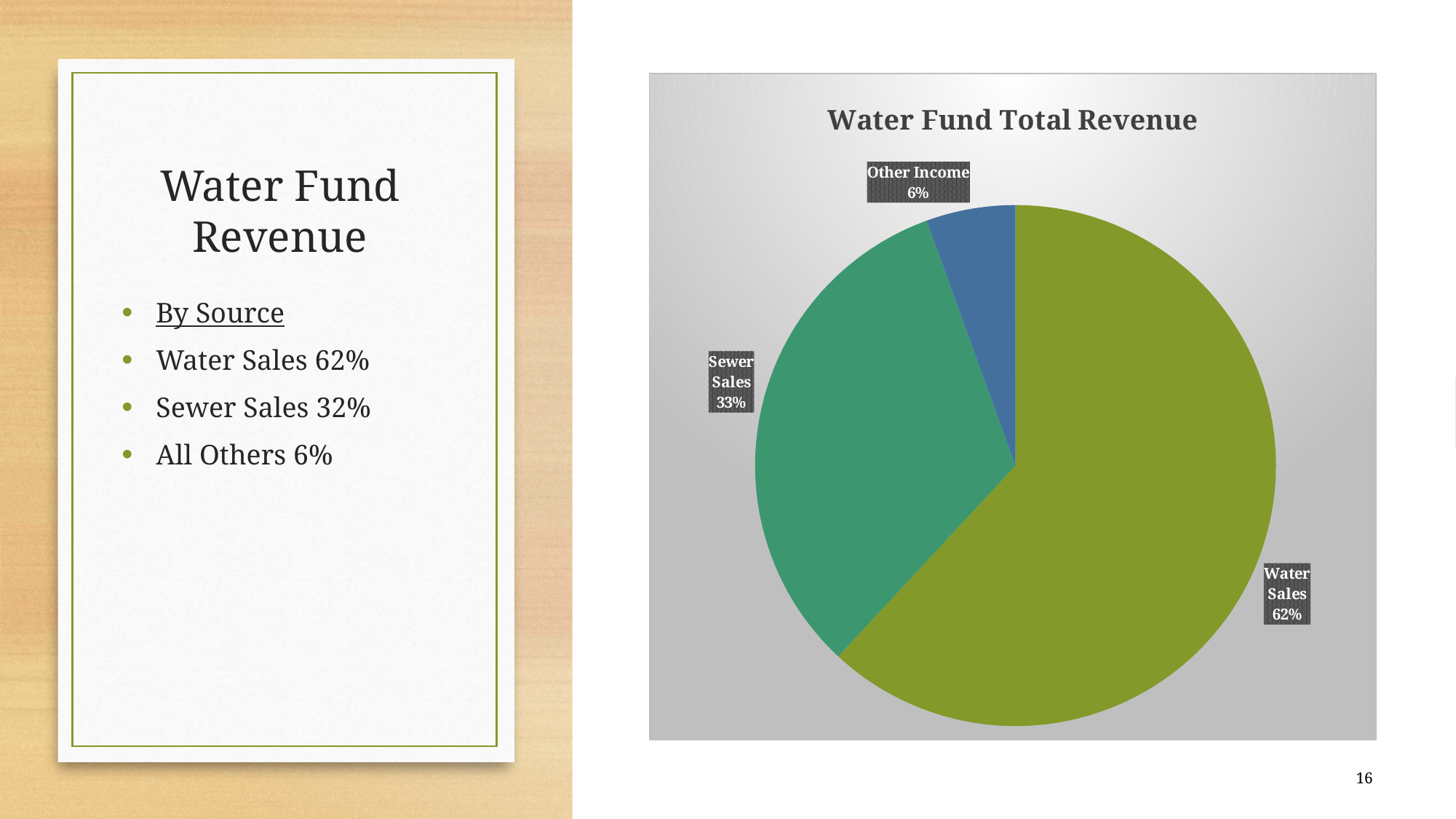
Which is larger, Sewer Sales or Other Income? Sewer Sales What share of the pie is Sewer Sales? 33% What is the chart's title? Water Fund Total Revenue What share of the pie is Other Income? 6% Which slice is the smallest? Other Income What is the difference in percentage points between Sewer Sales and Other Income? 27 Which slice is the largest? Water Sales What is the difference in percentage points between Water Sales and Sewer Sales? 29 How many slices does the pie chart have? 3 What kind of chart is shown on the slide? pie chart What colour is the Water Sales slice? green What share of the pie is Water Sales? 62%